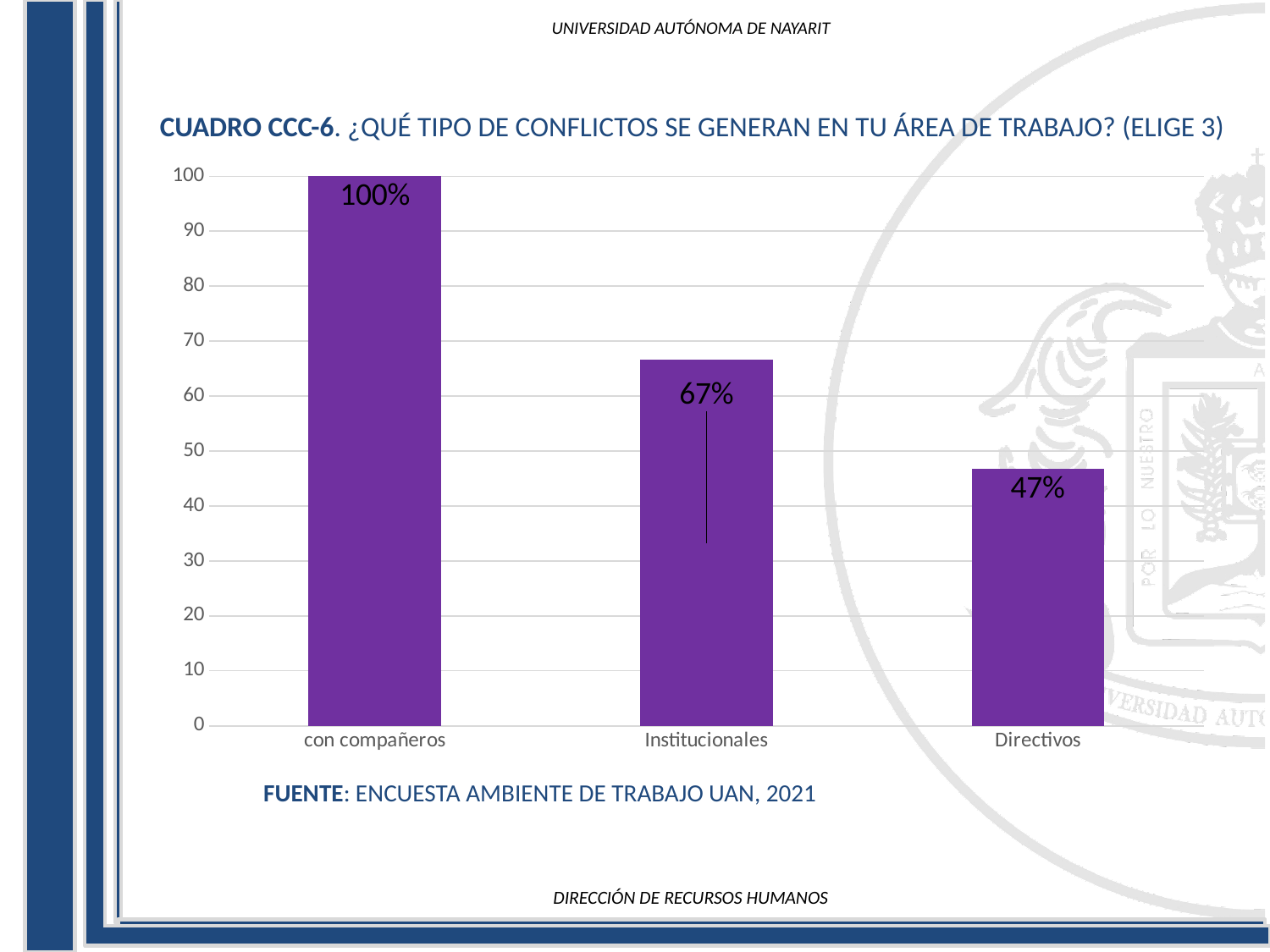
How many categories are shown on the x axis? 3 What is the difference between the values for Institucionales and Directivos? 20% Which category has the highest value? con compañeros Do the values rise or fall from left to right along the x axis? fall What is the value for con compañeros? 100% What is the value for Directivos? 47% What is the value for Institucionales? 67% What is the difference between the values for con compañeros and Institucionales? 33% Which category has the lowest value? Directivos Which is larger, the value for Institucionales or the value for Directivos? Institucionales What kind of chart is shown on the slide? bar chart Is the value for Directivos greater or less than 50? less